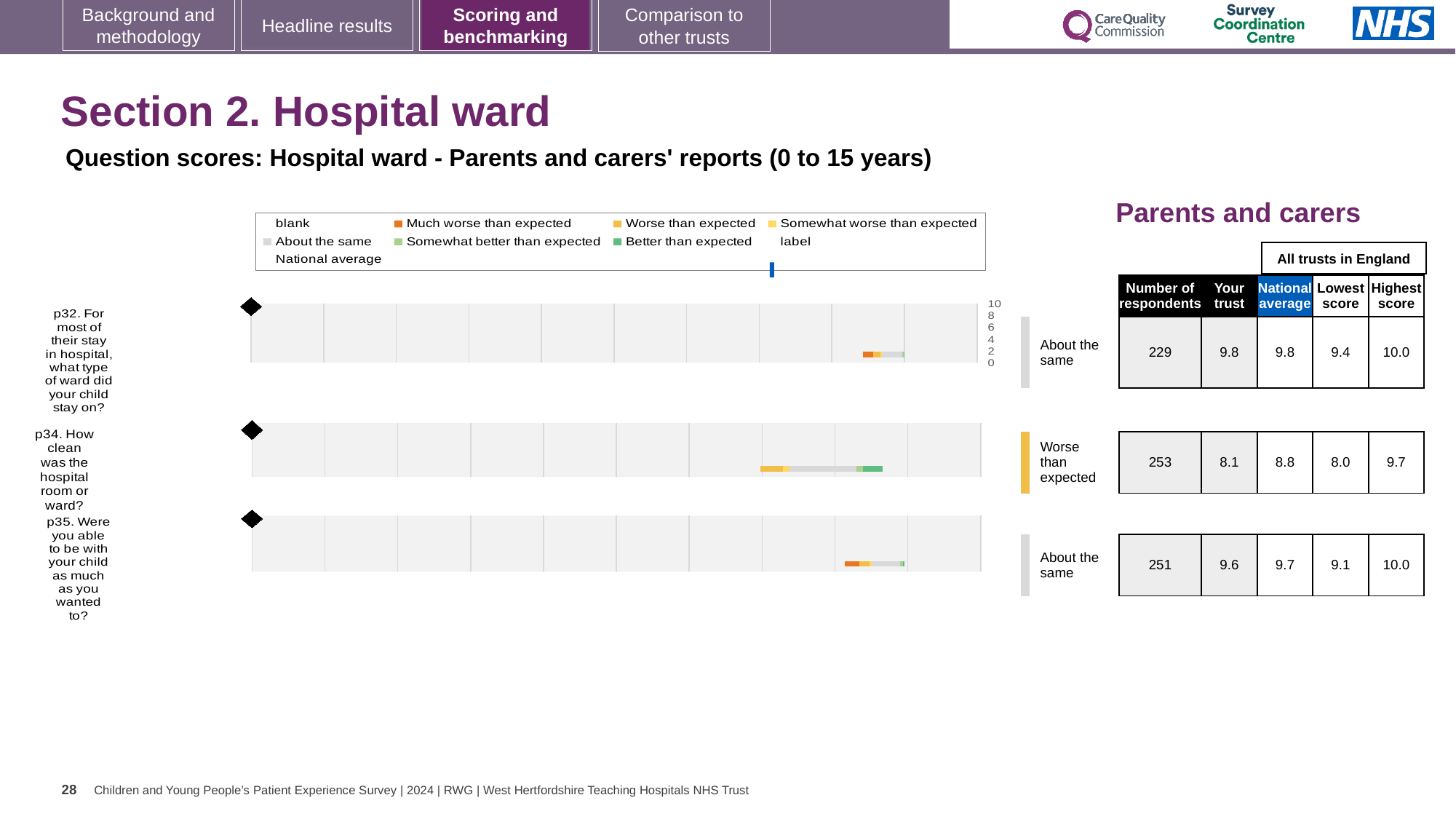
How many question rows (charts) are shown on the slide? 3 Is the 'Your trust' score for p34 higher or lower than the national average for p34? lower What is the 'Your trust' score for p34 (How clean was the hospital room or ward?)? 8.1 Which question has the lowest 'Your trust' score? p34. How clean was the hospital room or ward? What is the national average score for p34 (How clean was the hospital room or ward?)? 8.8 What benchmark category is shown for p34 (How clean was the hospital room or ward?)? Worse than expected Which question has the highest 'Your trust' score? p32. For most of their stay in hospital, what type of ward did your child stay on? What is the difference between the national average (8.8) and the 'Your trust' score (8.1) for p34? 0.7 What is the highest score across all trusts in England for p35 (Were you able to be with your child as much as you wanted to)? 10.0 Which legend entry is shown in orange? Much worse than expected How many respondents answered p32 (what type of ward did your child stay on)? 229 What kind of chart is used for each question row? bar chart